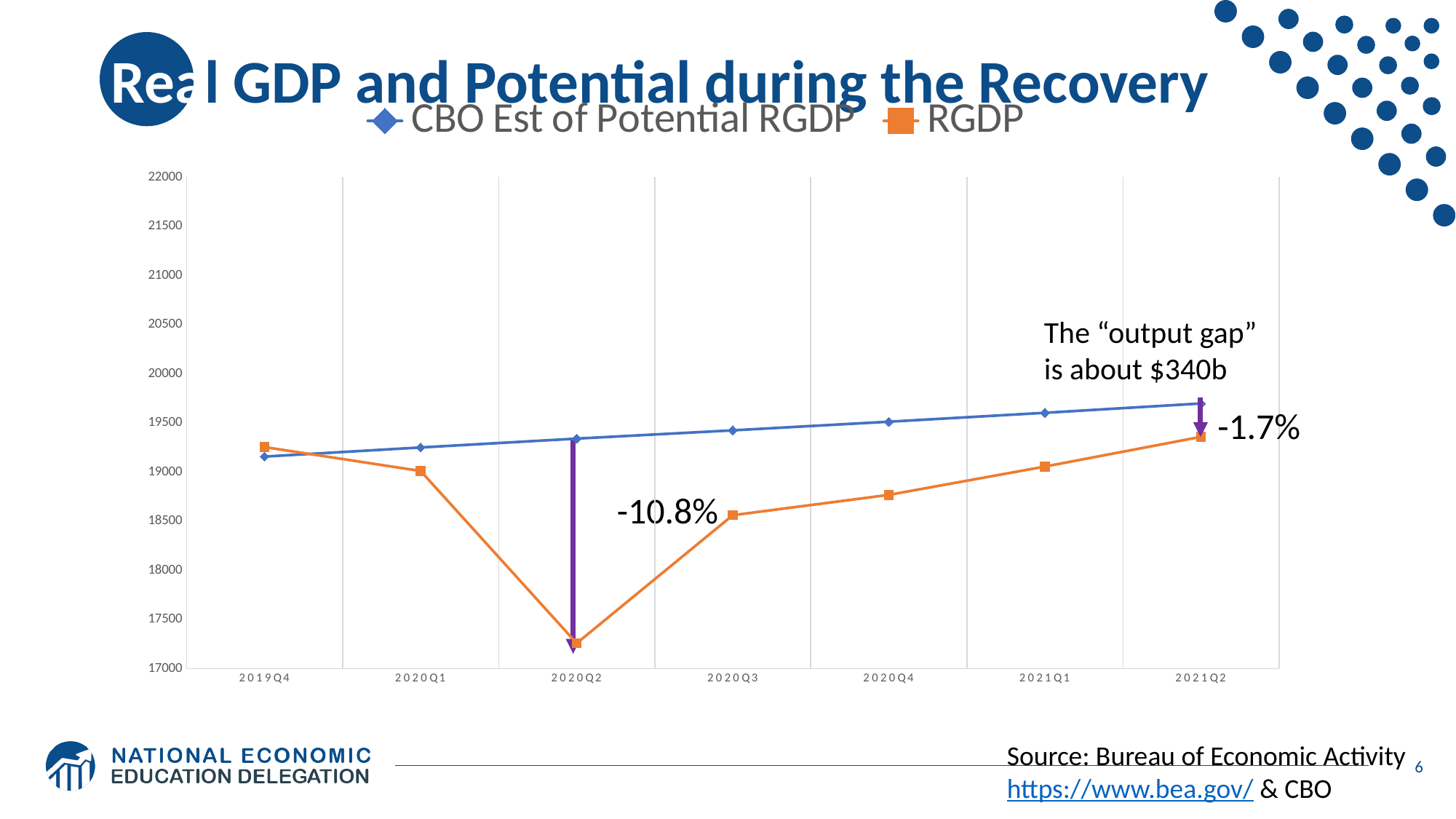
How many quarters are plotted along the x axis? 7 What percentage gap is annotated at 2020Q2? -10.8% In which quarter is RGDP at its lowest? 2020Q2 Is the RGDP value for 2020Q2 greater or less than 17500? less Does the CBO Est of Potential RGDP rise or fall from 2019Q4 to 2021Q2? rise In 2020Q2, which series has the higher value, CBO Est of Potential RGDP or RGDP? CBO Est of Potential RGDP In which quarter is the CBO Est of Potential RGDP at its highest? 2021Q2 Is the CBO Est of Potential RGDP value for 2021Q2 greater or less than 19500? greater How many series does the legend list? 2 What kind of chart is shown on the slide? line chart Is the RGDP value for 2020Q4 greater or less than 18500? greater According to the annotation, about how large is the output gap in 2021Q2? about $340b